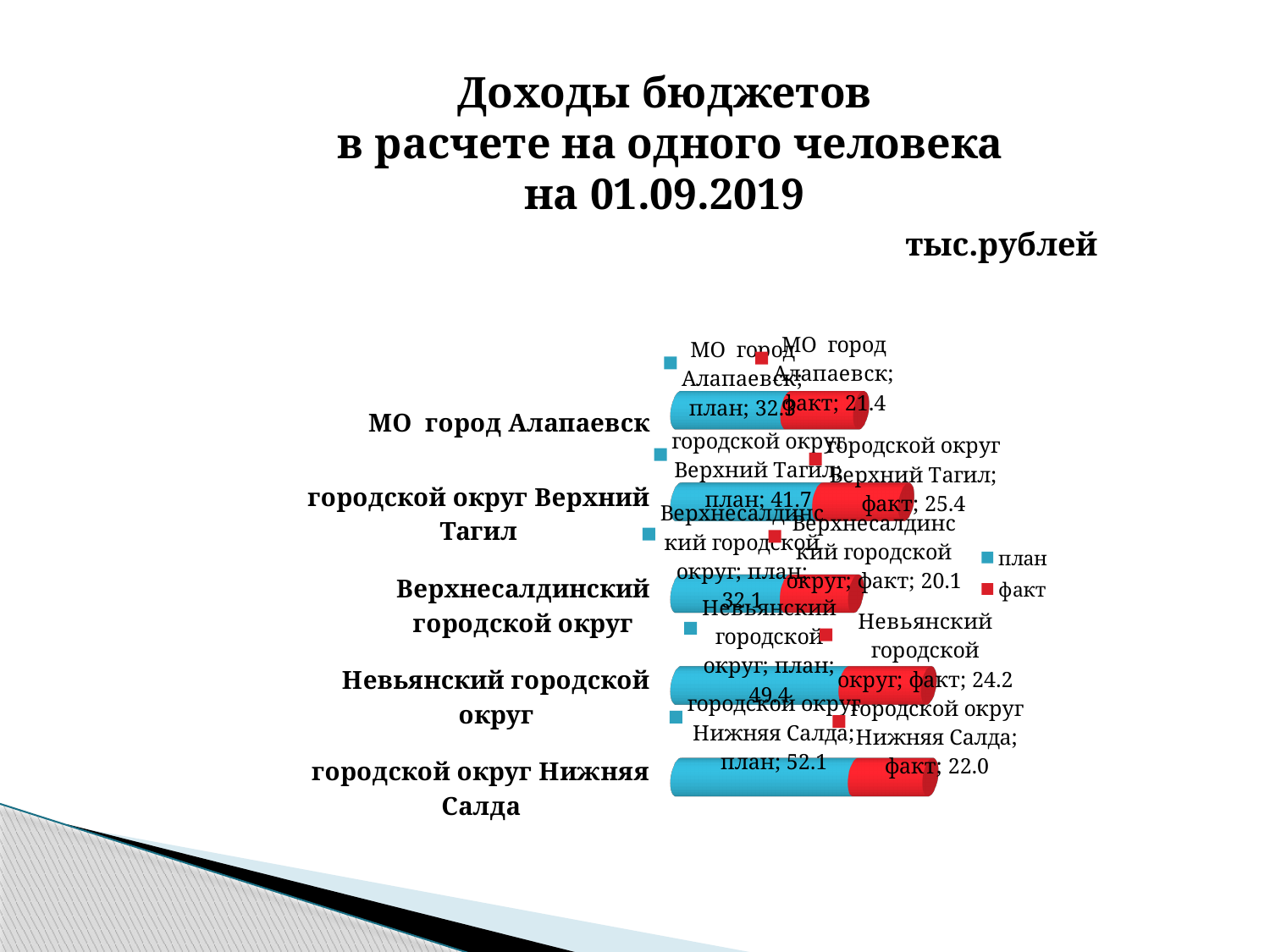
What is the план value for Верхнесалдинский городской округ? 32.1 What is the план value for городской округ Нижняя Салда? 52.1 How many categories (municipalities) are shown in the chart? 5 What is the факт value for городской округ Верхний Тагил? 25.4 What kind of chart is shown on the slide? bar chart What is the факт value for Невьянский городской округ? 24.2 Which category has the lowest факт value? Верхнесалдинский городской округ Which has the larger факт value: МО город Алапаевск or городской округ Нижняя Салда? городской округ Нижняя Салда Which category has the highest план value? городской округ Нижняя Салда What is the difference between план and факт for городской округ Верхний Тагил? 16.3 Which category has the highest факт value? городской округ Верхний Тагил How many series does the legend list? 2